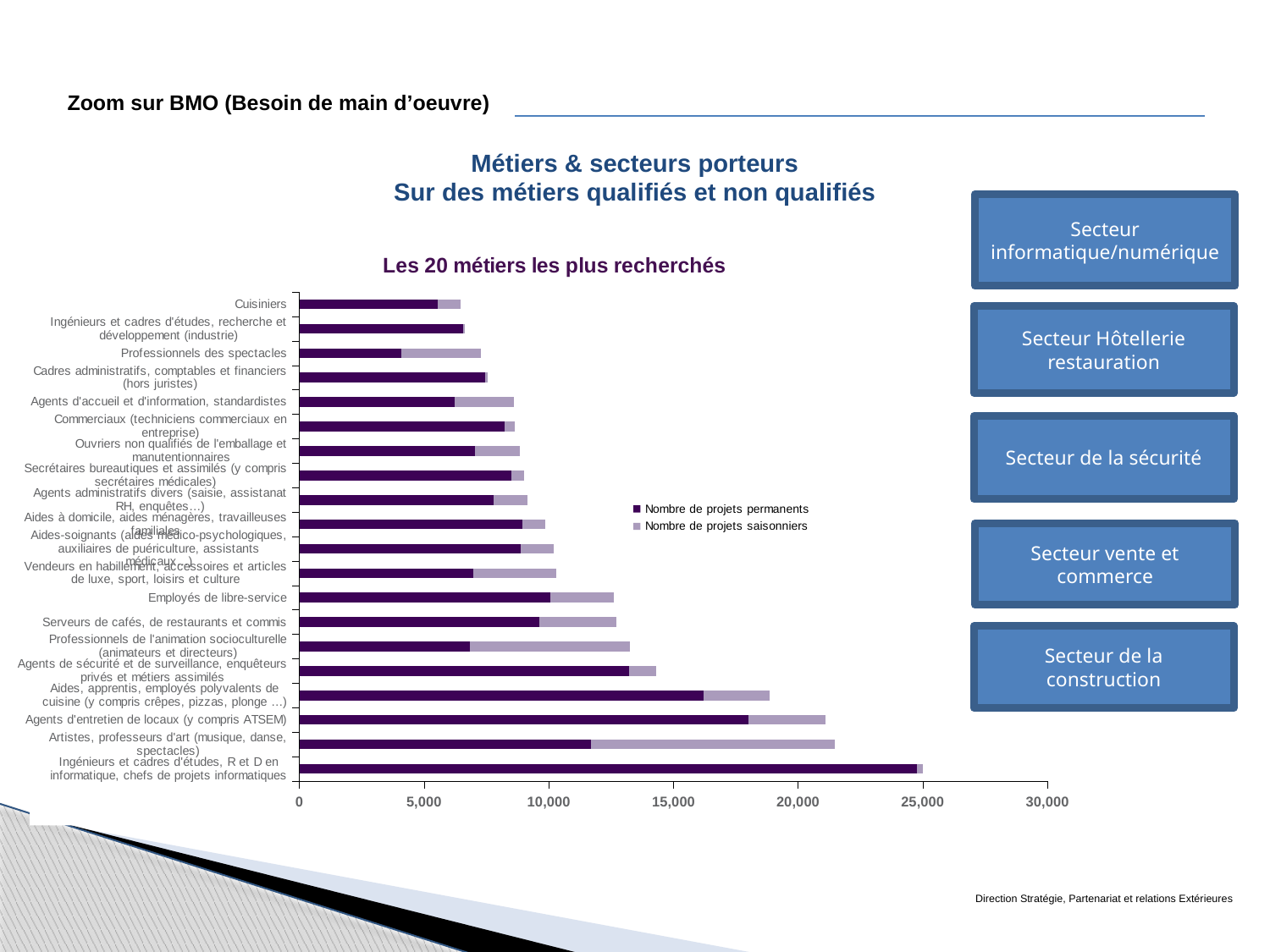
What kind of chart is shown under the title "Les 20 métiers les plus recherchés"? Bar chart Which has the longer total bar: "Agents d'entretien de locaux (y compris ATSEM)" or "Agents de sécurité et de surveillance, enquêteurs privés et métiers assimilés"? Agents d'entretien de locaux (y compris ATSEM) Is the total bar length for "Agents d'entretien de locaux (y compris ATSEM)" greater or less than 20,000? greater Which has more "projets permanents": "Aides, apprentis, employés polyvalents de cuisine" or "Artistes, professeurs d'art (musique, danse, spectacles)"? Aides, apprentis, employés polyvalents de cuisine Which has more "projets saisonniers": "Artistes, professeurs d'art (musique, danse, spectacles)" or "Cuisiniers"? Artistes, professeurs d'art (musique, danse, spectacles) Is the total bar length for "Cuisiniers" greater or less than 10,000? less Is the number of "projets permanents" for "Ingénieurs et cadres d'études, R et D en informatique, chefs de projets informatiques" greater or less than 20,000? greater Which métier has the longest bar overall in the chart? Ingénieurs et cadres d'études, R et D en informatique, chefs de projets informatiques What are the two series named in the chart legend? Nombre de projets permanents; Nombre de projets saisonniers How many series does the legend of the chart list? 2 How many métiers (categories) are plotted in the chart? 20